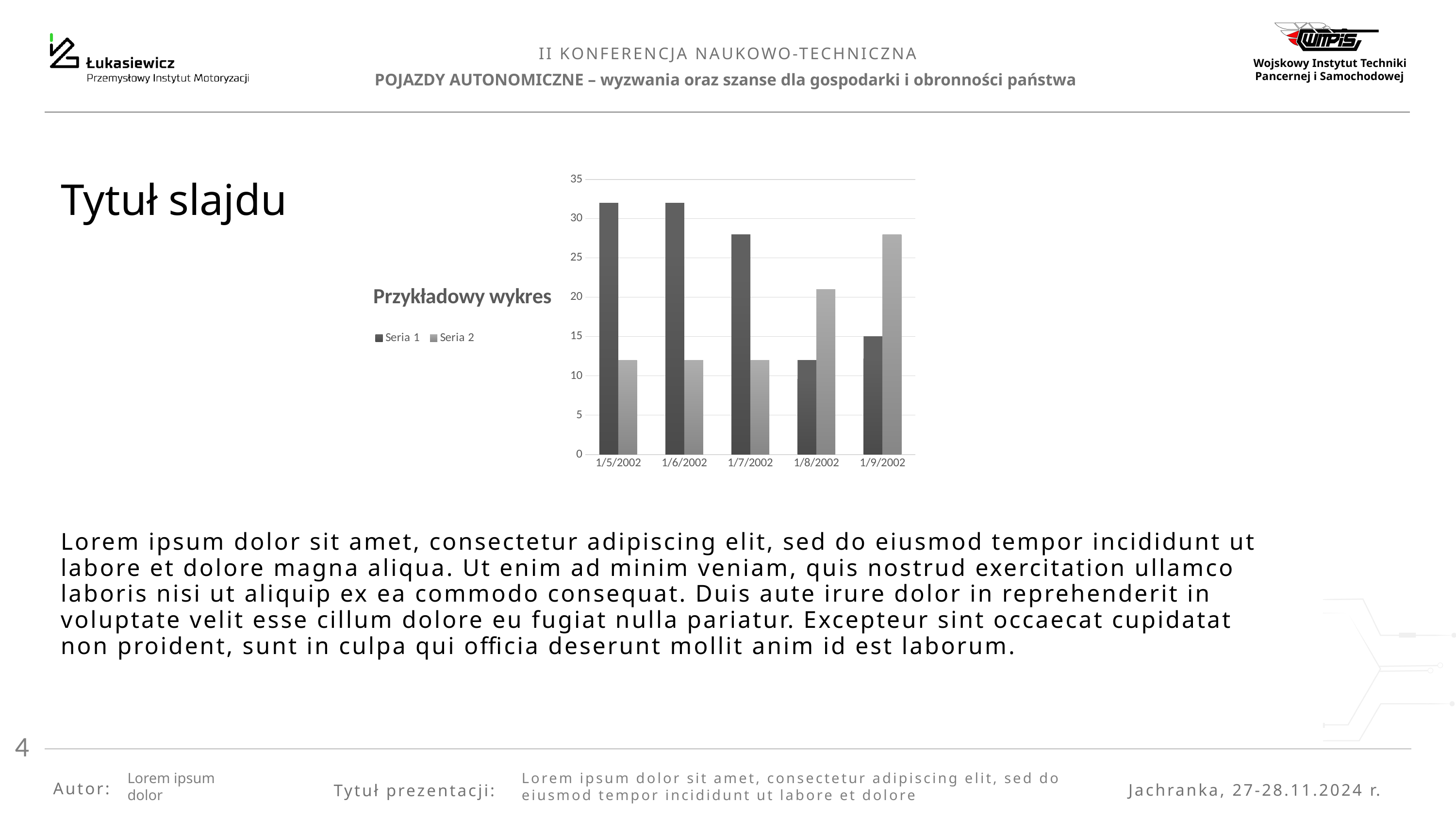
Is the value of Seria 1 for 1/8/2002 greater or less than 15? less For 1/5/2002, which series has the larger value, Seria 1 or Seria 2? Seria 1 For which category is the value of Seria 2 highest? 1/9/2002 How many categories are shown on the x axis of the chart? 5 Is the value of Seria 2 for 1/9/2002 greater or less than 25? greater How many series does the chart legend list? 2 Is the value of Seria 2 for 1/5/2002 greater or less than 15? less For which category is the value of Seria 1 lowest? 1/8/2002 For 1/9/2002, which series has the larger value, Seria 1 or Seria 2? Seria 2 What is the title of the chart? Przykładowy wykres What kind of chart is shown on the slide? bar chart